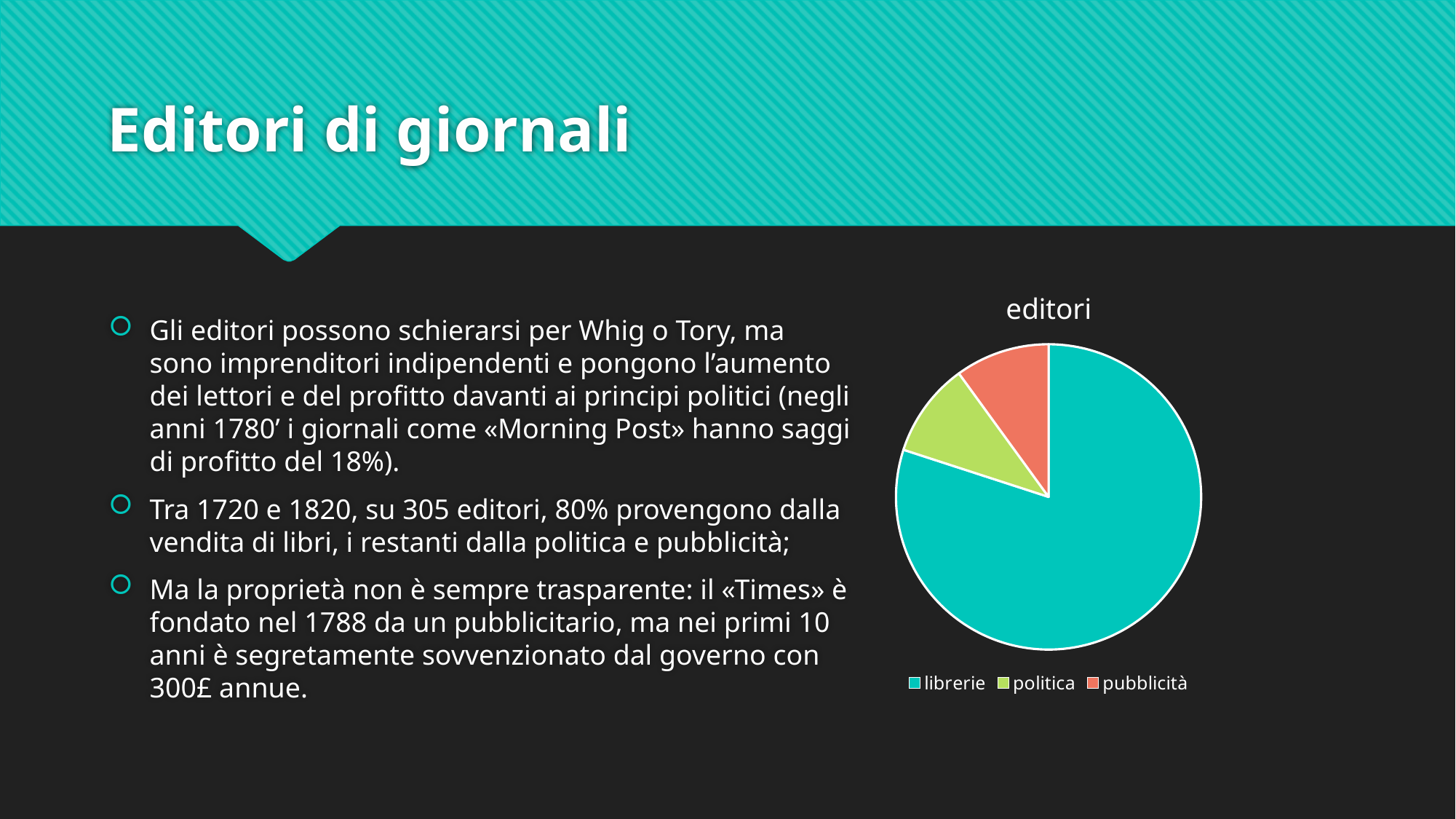
What is the title of the chart? editori Which category has the largest slice of the pie? librerie How many slices does the pie chart have? 3 Which categories are listed in the chart legend? librerie, politica, pubblicità What colour is the librerie slice in the pie chart? teal What kind of chart is shown on the slide? pie chart How many entries does the chart legend list? 3 Which slice is larger, librerie or politica? librerie Is the librerie slice more or less than half of the pie? more Which slice is larger, librerie or pubblicità? librerie